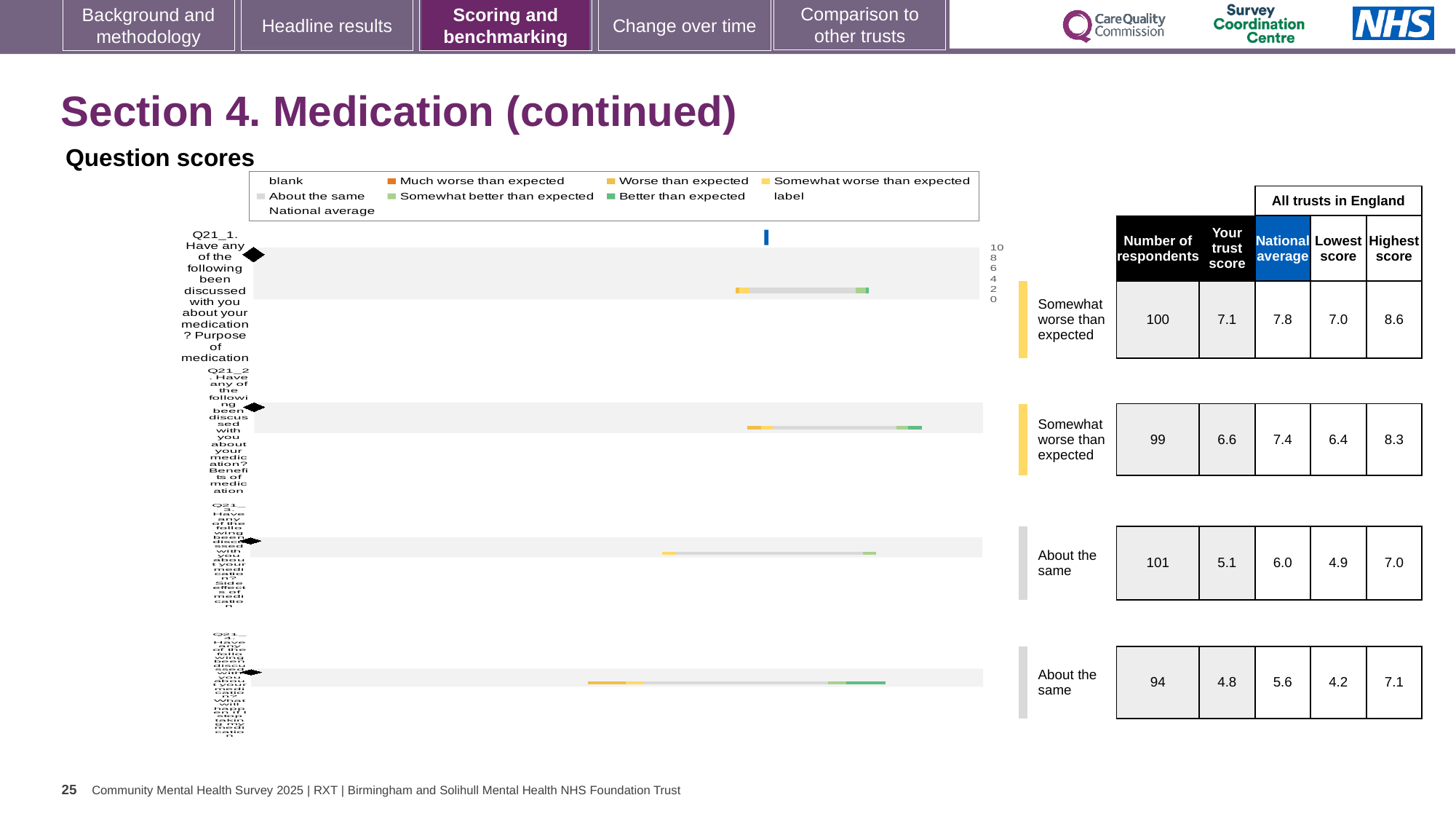
What is the national average for Q21_2 (Benefits of medication)? 7.4 What is the 'Your trust score' value for Q21_1 (Purpose of medication)? 7.1 Which question has the lowest 'Your trust score'? Q21_4 How many respondents are listed for the third question, Q21_3 (Side effects of medication)? 101 What colour does the legend use for 'Somewhat worse than expected'? Yellow For Q21_1, what is the difference between the national average and the trust score? 0.7 What kind of chart is used to show the question scores on this slide? bar chart Which question has the highest 'Your trust score'? Q21_1 What benchmark category is shown for Q21_3 (Side effects of medication)? About the same For Q21_2, which is larger: the trust score or the national average? National average How many questions (bars) are plotted in the question scores chart? 4 What is the highest score across all trusts in England for the fourth question, Q21_4? 7.1